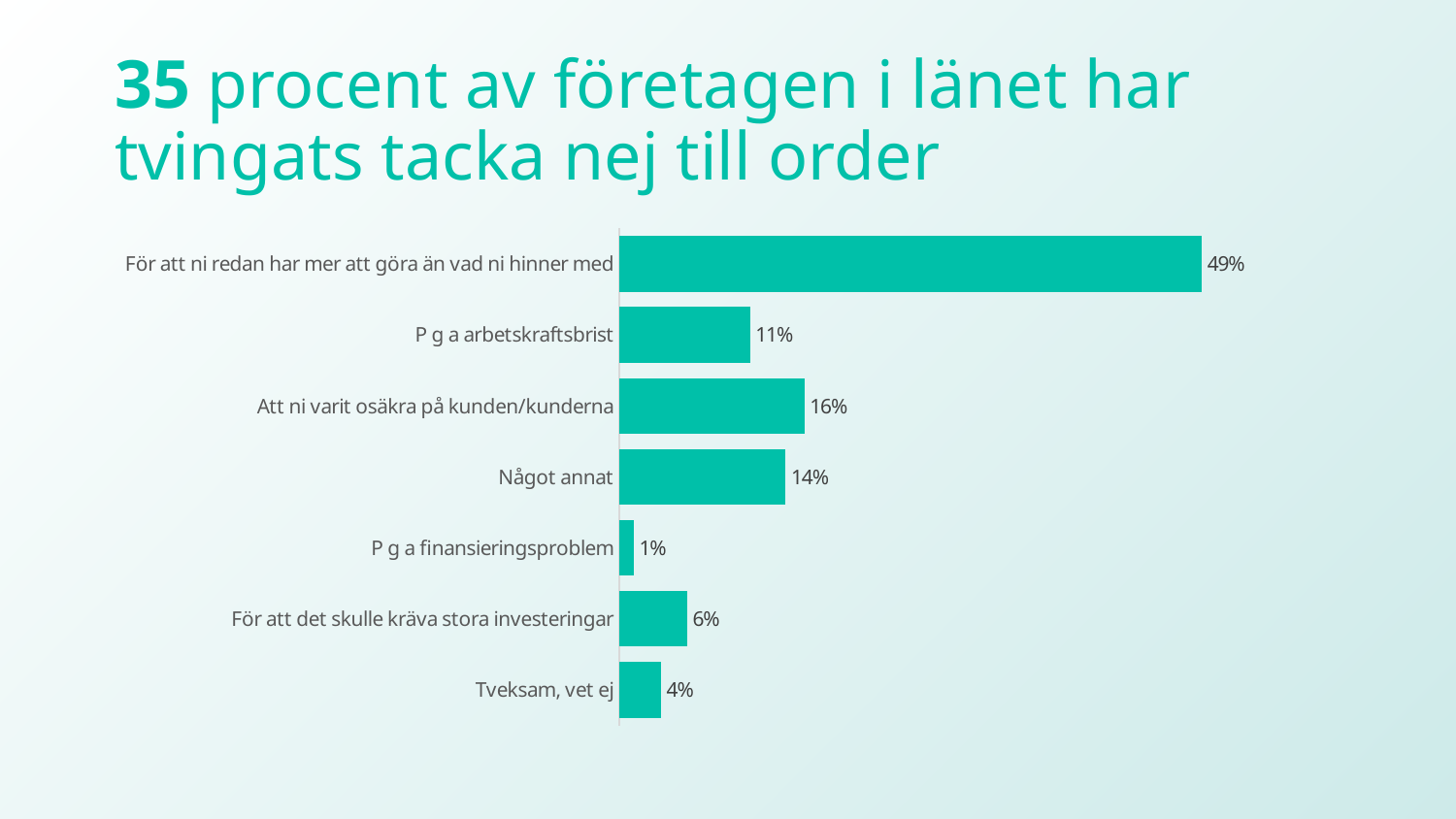
What is the value for "Tveksam, vet ej"? 4% Which category has the highest value? För att ni redan har mer att göra än vad ni hinner med What is the value for "Att ni varit osäkra på kunden/kunderna"? 16% Which is larger, the value for "För att det skulle kräva stora investeringar" or the value for "Tveksam, vet ej"? För att det skulle kräva stora investeringar What number is highlighted in bold in the slide title? 35 What is the value for "För att ni redan har mer att göra än vad ni hinner med"? 49% Which category has the lowest value? P g a finansieringsproblem What is the difference between the values for "För att ni redan har mer att göra än vad ni hinner med" and "P g a arbetskraftsbrist"? 38% What is the value for "P g a arbetskraftsbrist"? 11% How many categories are shown in the chart? 7 What kind of chart is shown on the slide? Bar chart What is the difference between the values for "Att ni varit osäkra på kunden/kunderna" and "Något annat"? 2%